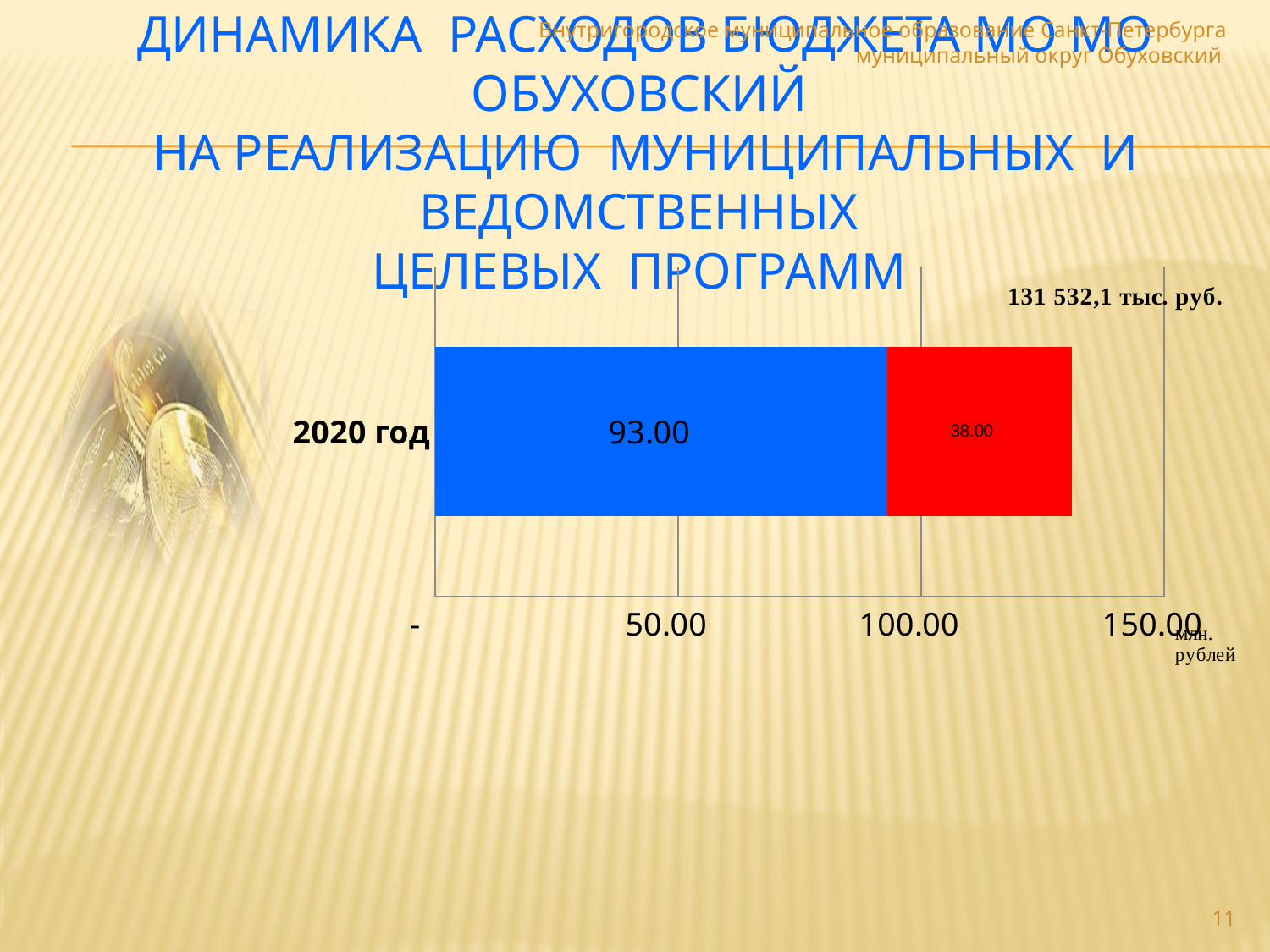
What value is printed on the blue segment of the bar for 2020 год? 93.00 How many segments make up the bar for 2020 год? 2 What is the difference between the blue segment value and the red segment value for 2020 год? 55.00 What is the category label shown on the chart's vertical axis? 2020 год What value is printed on the red segment of the bar for 2020 год? 38.00 What amount is printed in the annotation above the right end of the bar? 131 532,1 тыс. руб. What unit is written next to the horizontal axis of the chart? млн. рублей What is the total of the stacked bar for 2020 год? 131.00 How many categories are plotted on the chart? 1 Which segment of the 2020 год bar is larger, the blue one or the red one? the blue one What kind of chart is shown on the slide? stacked bar chart Is the total length of the bar for 2020 год greater or less than 100.00? greater